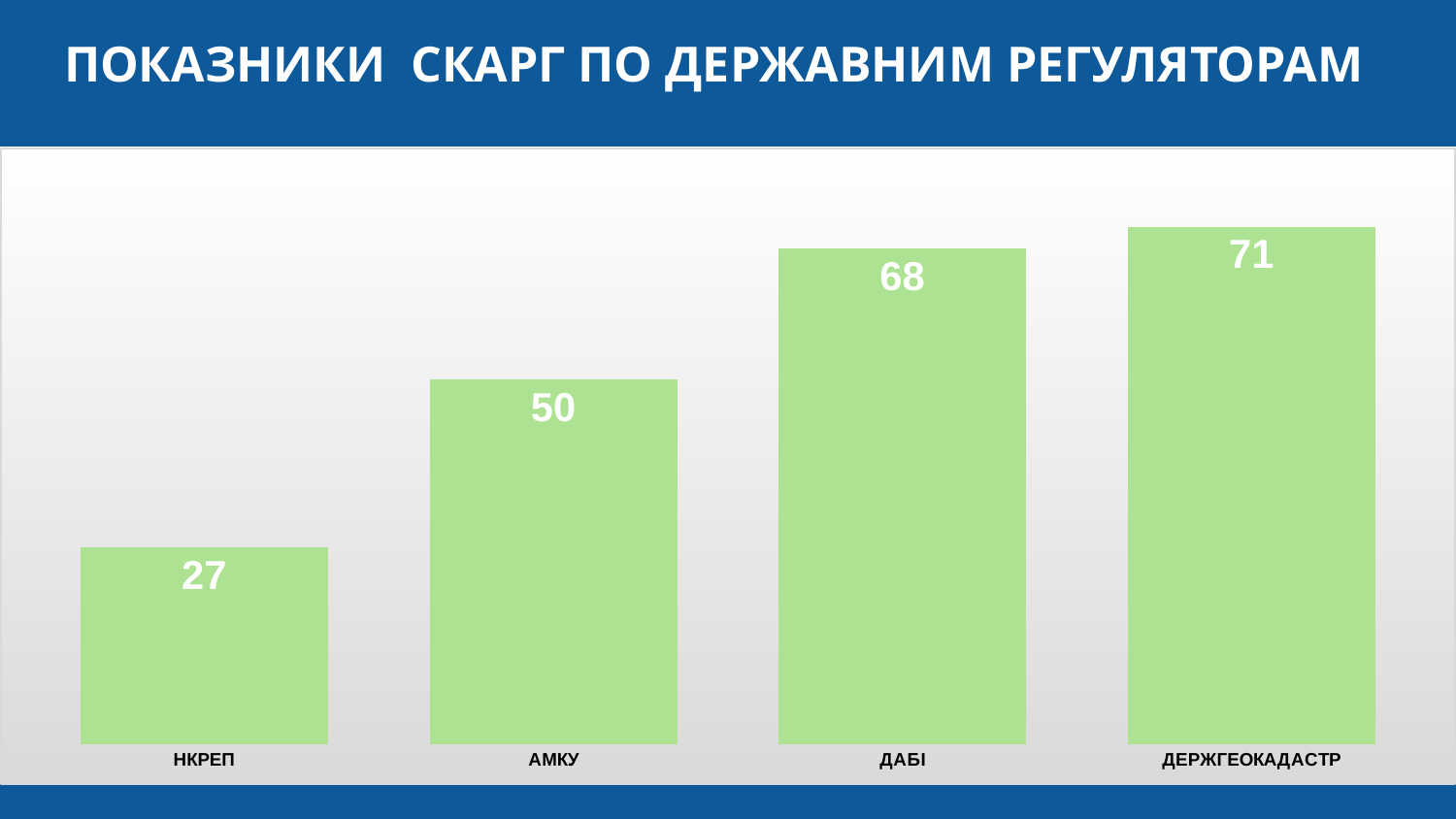
What is the value for НКРЕП? 27 What is the value for АМКУ? 50 Which category has the lowest value? НКРЕП What is the difference between the values for ДАБІ and АМКУ? 18 Which is larger, the value for АМКУ or the value for ДАБІ? ДАБІ Do the values rise or fall from left to right along the x axis? rise Which category has the highest value? ДЕРЖГЕОКАДАСТР How many categories are shown in the chart? 4 What kind of chart is shown on the slide? bar chart What is the difference between the values for ДЕРЖГЕОКАДАСТР and НКРЕП? 44 What is the value for ДЕРЖГЕОКАДАСТР? 71 What is the value for ДАБІ? 68